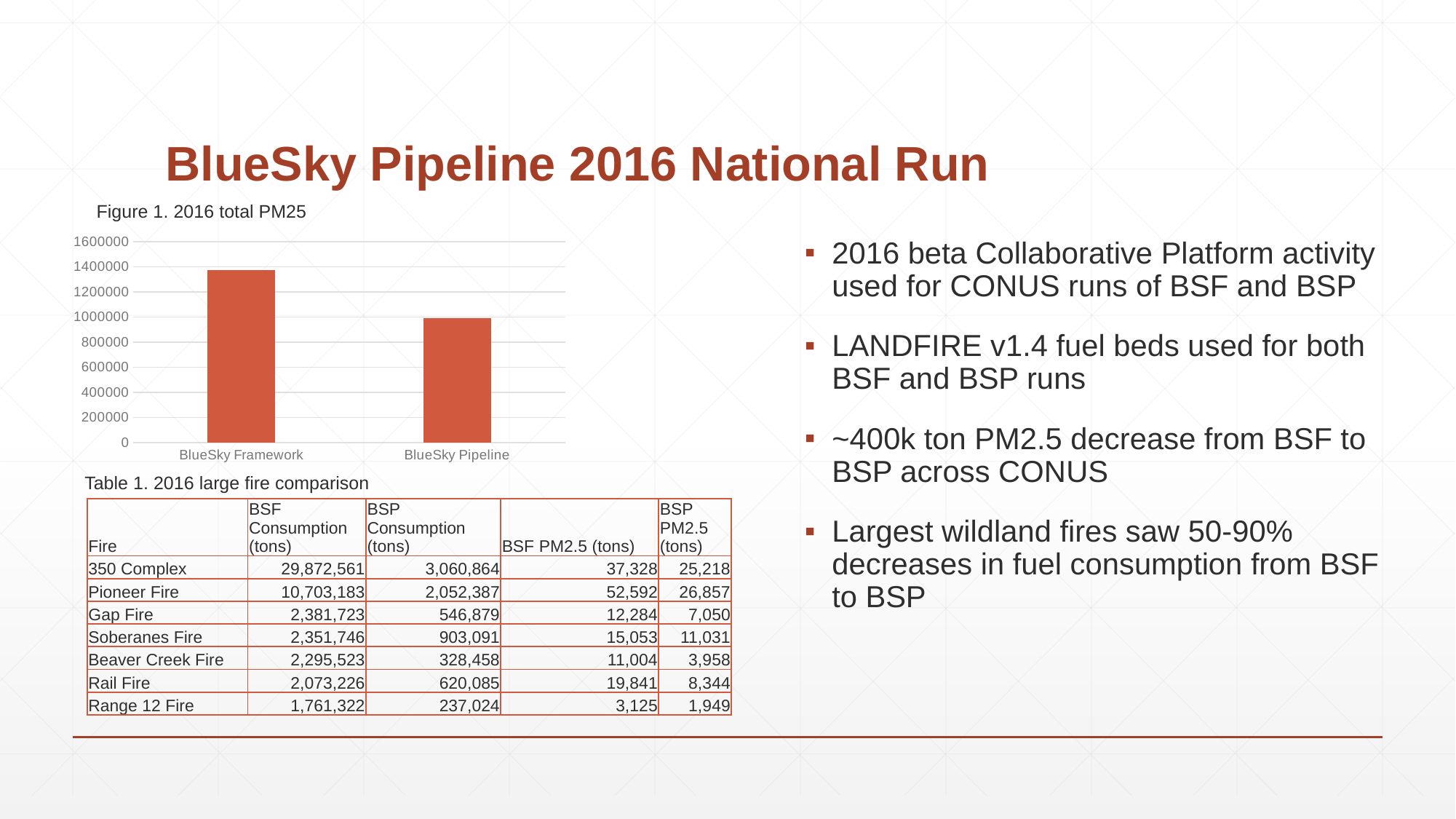
What kind of chart is Figure 1. 2016 total PM25? bar chart In the Figure 1. 2016 total PM25 chart, is the value for BlueSky Pipeline greater or less than 800000? greater In the Figure 1. 2016 total PM25 chart, which category has the highest value? BlueSky Framework How many bars are plotted in the Figure 1. 2016 total PM25 chart? 2 What is the title of the chart on the slide? Figure 1. 2016 total PM25 In the Figure 1. 2016 total PM25 chart, is the value for BlueSky Framework greater or less than 1600000? less In the Figure 1. 2016 total PM25 chart, which is larger: BlueSky Framework or BlueSky Pipeline? BlueSky Framework In the Figure 1. 2016 total PM25 chart, is the value for BlueSky Framework greater or less than 1200000? greater What is the highest tick value shown on the vertical axis of the Figure 1. 2016 total PM25 chart? 1600000 In the Figure 1. 2016 total PM25 chart, do the values rise or fall from BlueSky Framework to BlueSky Pipeline? fall In the Figure 1. 2016 total PM25 chart, which category has the lowest value? BlueSky Pipeline